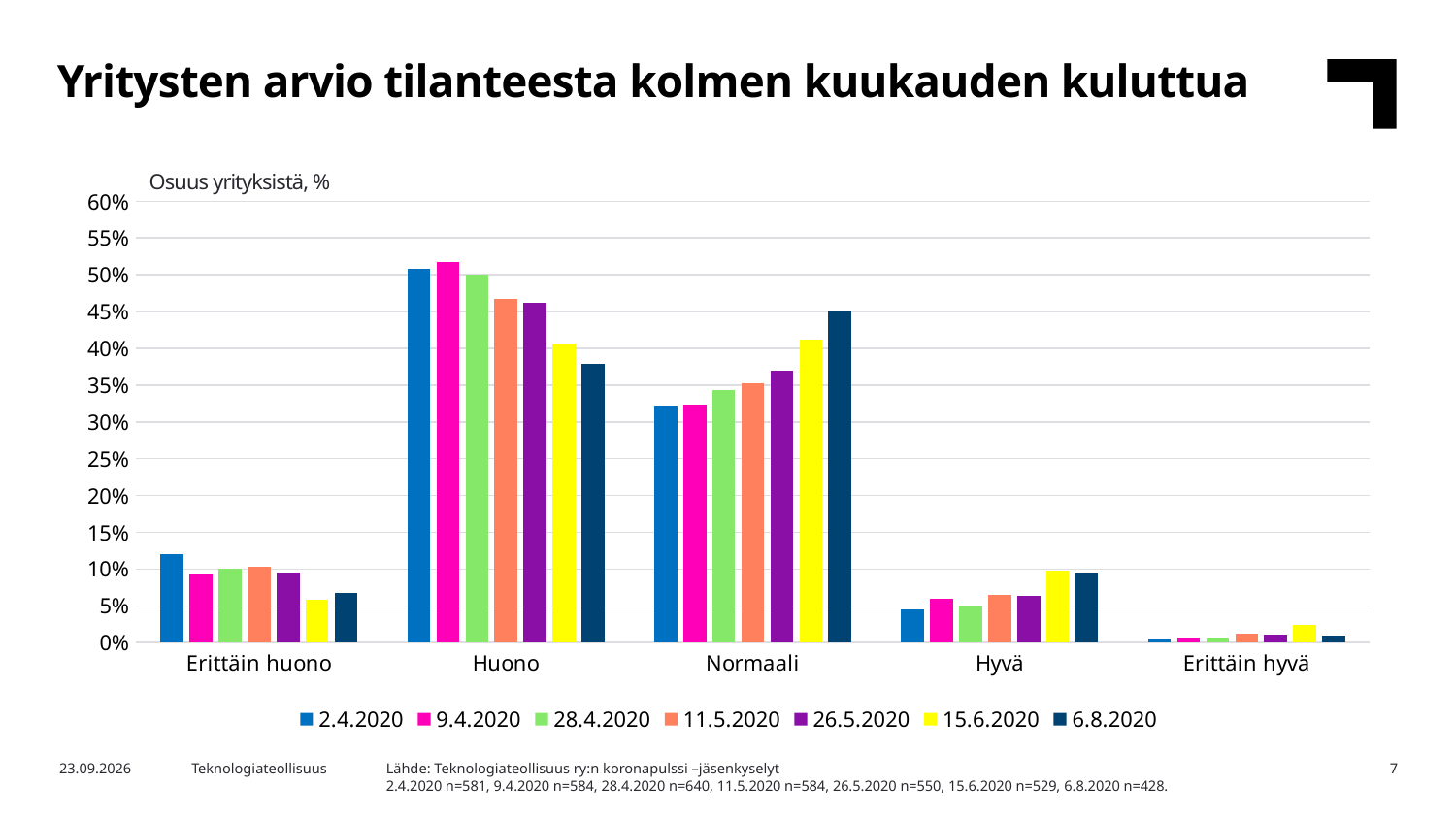
Is the value for Huono in the 2.4.2020 series greater or less than 45%? greater Is the value for Normaali in the 6.8.2020 series greater or less than 40%? greater How many categories are shown on the x axis? 5 How many series does the legend list? 7 Which category has the highest value in the 9.4.2020 series? Huono For the Normaali category, do the values rise or fall from the 2.4.2020 series to the 6.8.2020 series? rise Which category has the lowest value in the 6.8.2020 series? Erittäin hyvä What is the label shown above the vertical axis? Osuus yrityksistä, % What kind of chart is shown on the slide? bar chart Is the value for Hyvä in the 15.6.2020 series greater or less than 15%? less In the 6.8.2020 series, which is larger: Huono or Normaali? Normaali